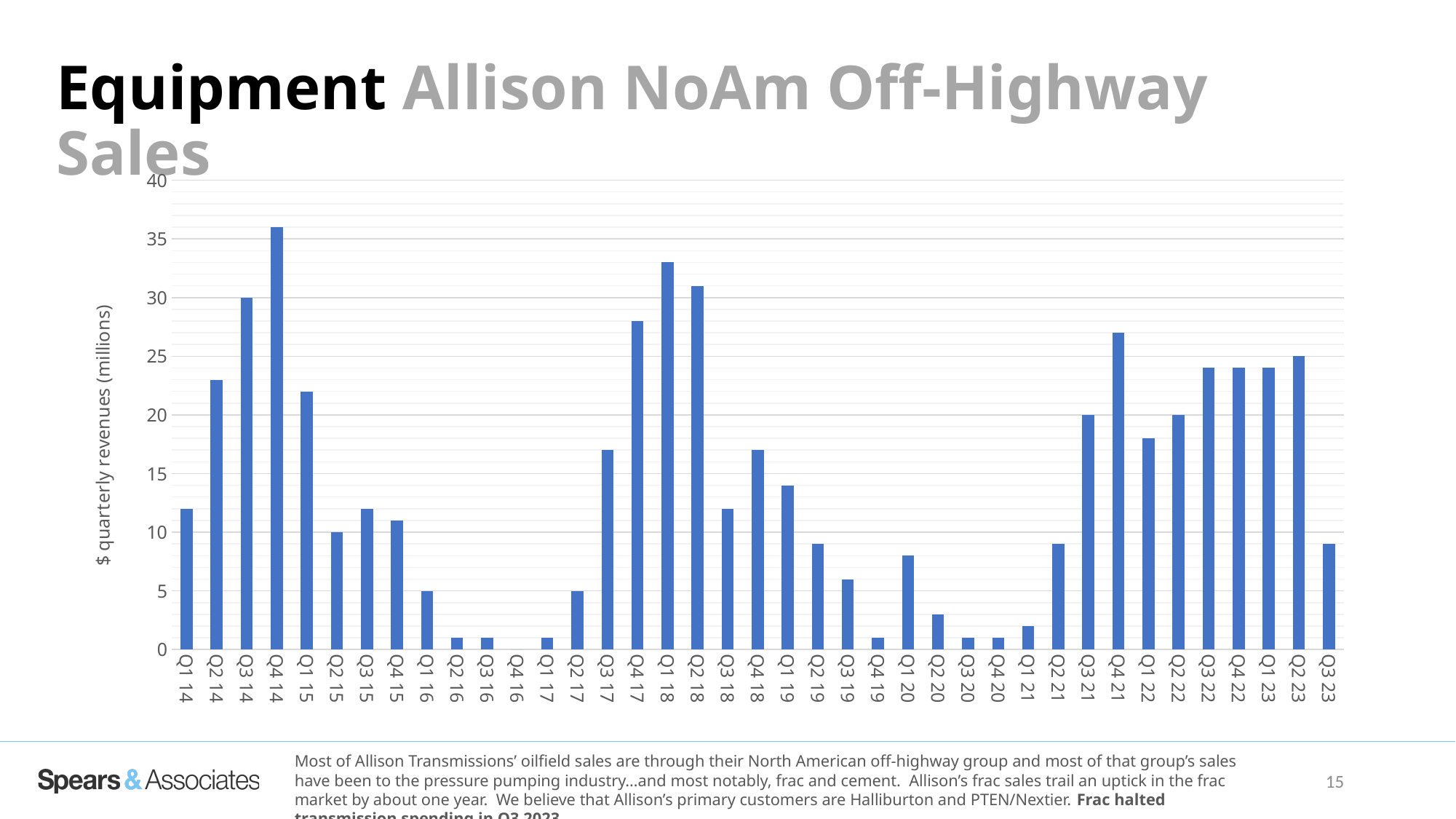
Do the values rise or fall from Q1 14 to Q4 14? rise Is the value for Q3 23 greater or less than 10? less What is the label on the vertical axis? $ quarterly revenues (millions) What is the value for Q2 15? 10 Which quarter has the highest value in the chart? Q4 14 Is the value for Q4 21 greater or less than 25? greater Which is larger, the value for Q4 14 or the value for Q1 18? Q4 14 What is the value for Q3 14? 30 What is the difference between the values for Q3 14 and Q2 15? 20 How many quarters are shown on the x axis? 39 What is the value for Q2 23? 25 What kind of chart is shown on the slide? bar chart